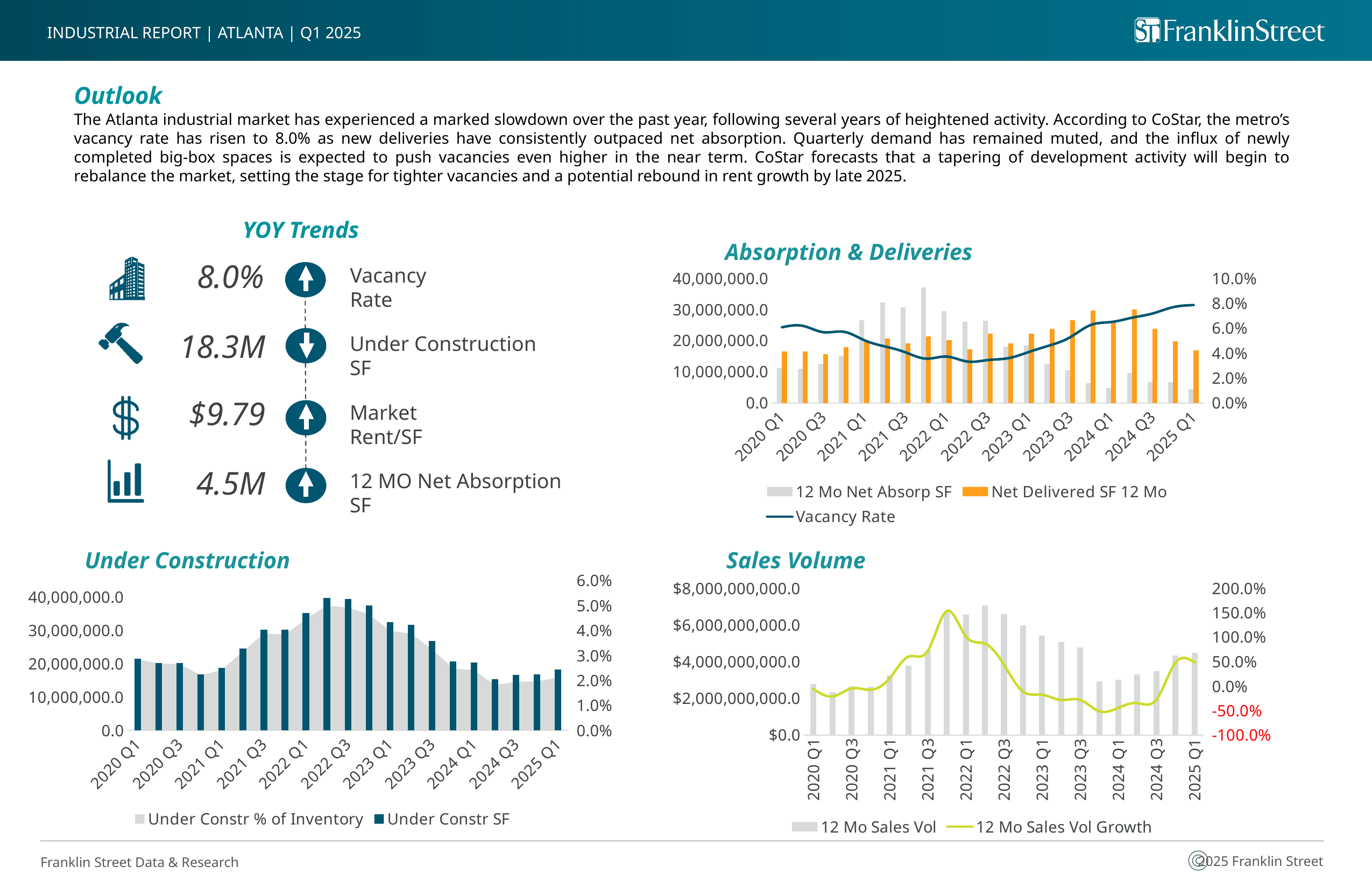
In the 'Absorption & Deliveries' chart, what colour are the Net Delivered SF 12 Mo bars? Orange In the 'Under Construction' chart, does Under Constr SF rise or fall from 2022 Q3 to 2024 Q1? fall What kind of chart is the 'Under Construction' chart? Combination bar and area chart How many series does the legend of the 'Sales Volume' chart list? 2 In the 'Sales Volume' chart, is the 12 Mo Sales Vol for 2025 Q1 greater or less than $6,000,000,000.0? less In the 'Sales Volume' chart, is the 12 Mo Sales Vol Growth for 2024 Q1 greater or less than 0.0%? less How many series does the legend of the 'Absorption & Deliveries' chart list? 3 In the 'Under Construction' chart, is the Under Constr SF for 2025 Q1 greater or less than 20,000,000.0? less In the 'Absorption & Deliveries' chart, which quarter has the highest 12 Mo Net Absorp SF? 2021 Q4